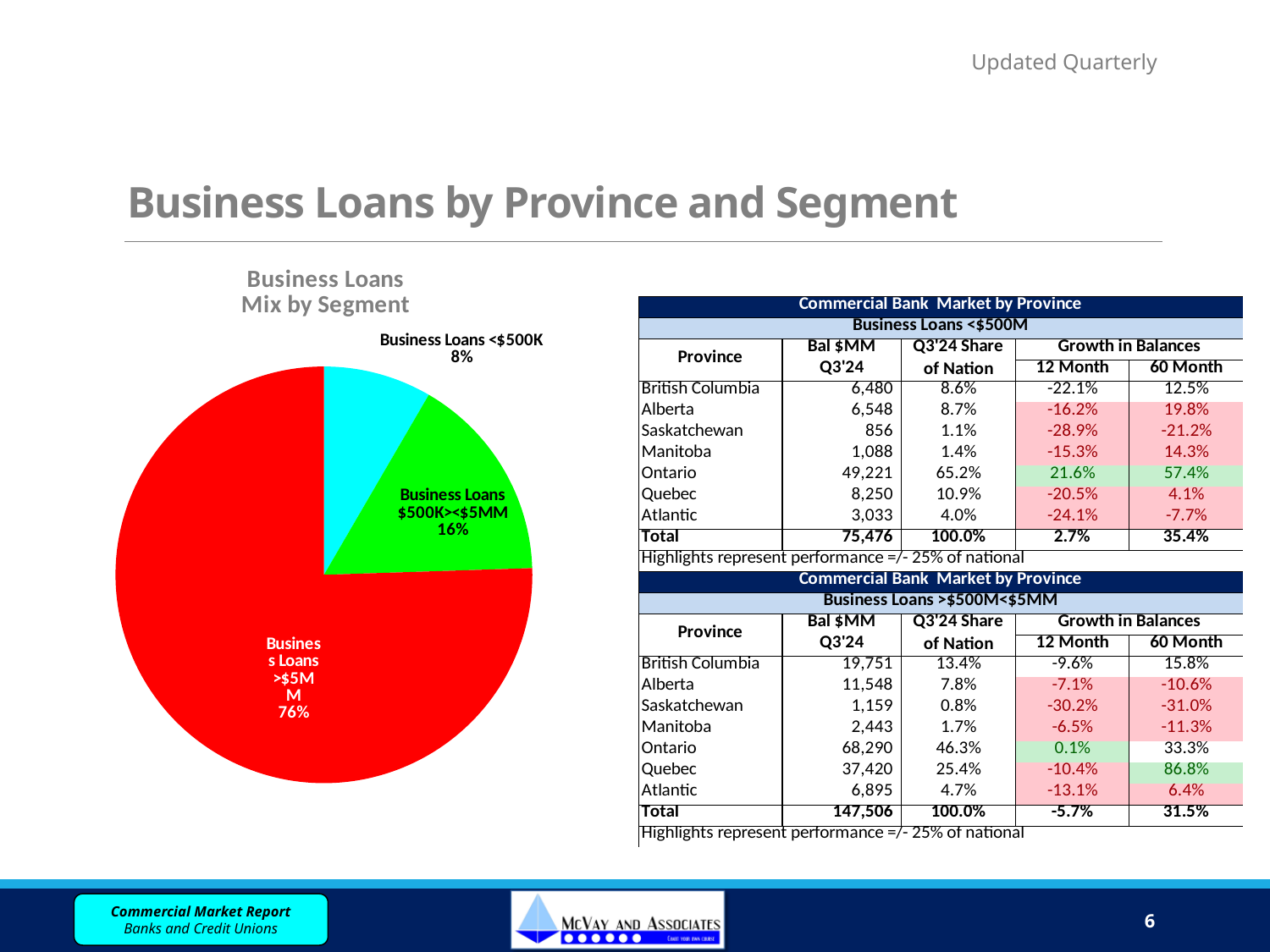
What share of the pie is Business Loans <$500K? 8% What share of the pie is Business Loans >$5MM? 76% What is the difference in percentage points between the Business Loans >$5MM slice and the Business Loans $500K><$5MM slice? 60 percentage points What share of the pie is Business Loans $500K><$5MM? 16% Which is larger, the Business Loans $500K><$5MM slice or the Business Loans <$500K slice? Business Loans $500K><$5MM What is the title of the pie chart? Business Loans Mix by Segment What is the difference in percentage points between the Business Loans $500K><$5MM slice and the Business Loans <$500K slice? 8 percentage points How many slices does the pie chart have? 3 Which segment has the smallest share of the pie? Business Loans <$500K What type of chart is shown on the slide? Pie chart Which segment has the largest share of the pie? Business Loans >$5MM What colour is the Business Loans >$5MM slice of the pie chart? Red